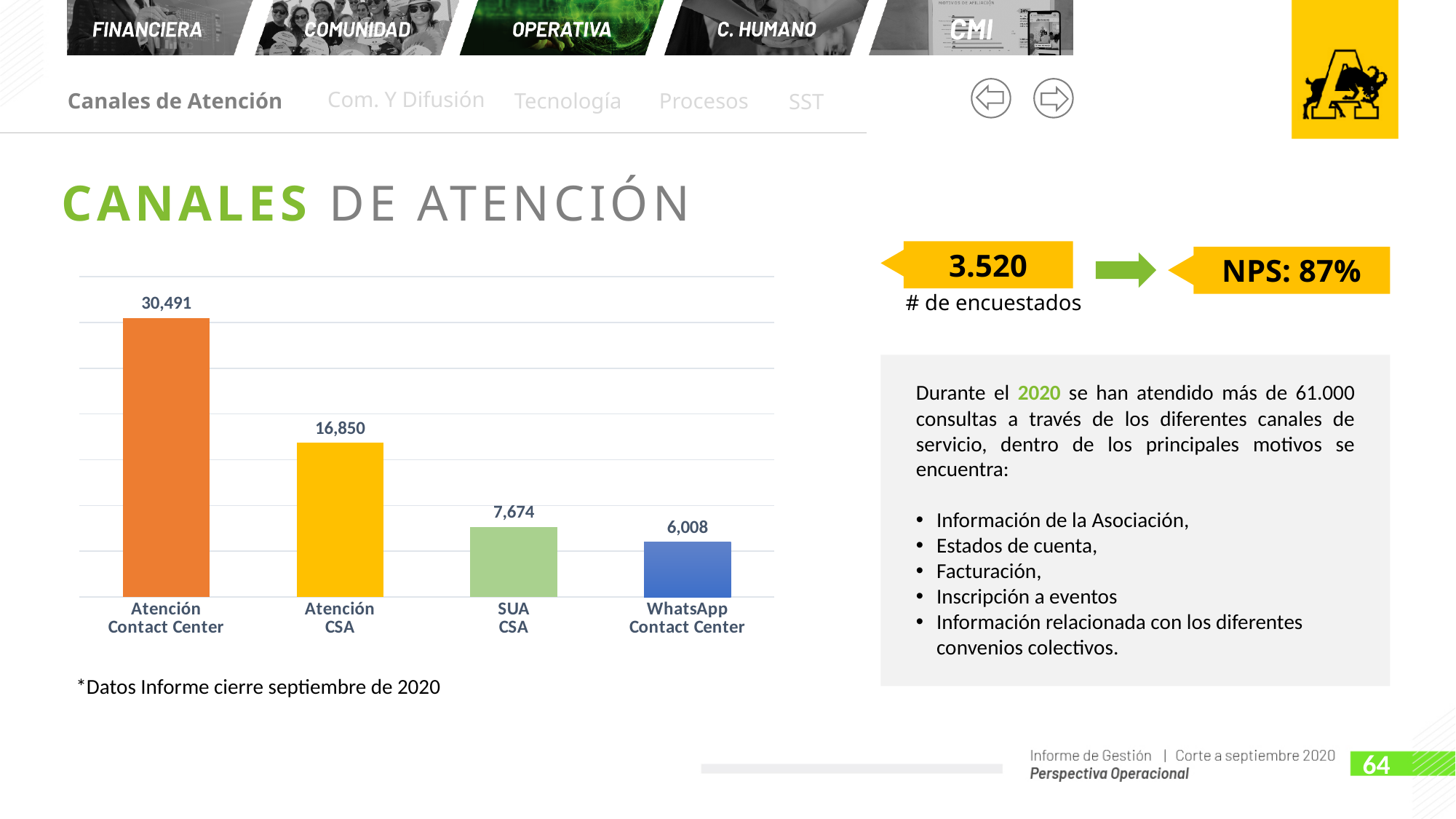
What is the difference between SUA CSA and WhatsApp Contact Center? 1,666 Which is larger, Atención CSA or SUA CSA? Atención CSA What kind of chart is shown on the slide? Bar chart What is the value for WhatsApp Contact Center? 6,008 How many categories are shown in the chart? 4 Do the values rise or fall from left to right across the categories? Fall What is the value for Atención CSA? 16,850 What is the difference between Atención Contact Center and Atención CSA? 13,641 Which category has the lowest value? WhatsApp Contact Center Which category has the highest value? Atención Contact Center What is the value for Atención Contact Center? 30,491 What is the value for SUA CSA? 7,674